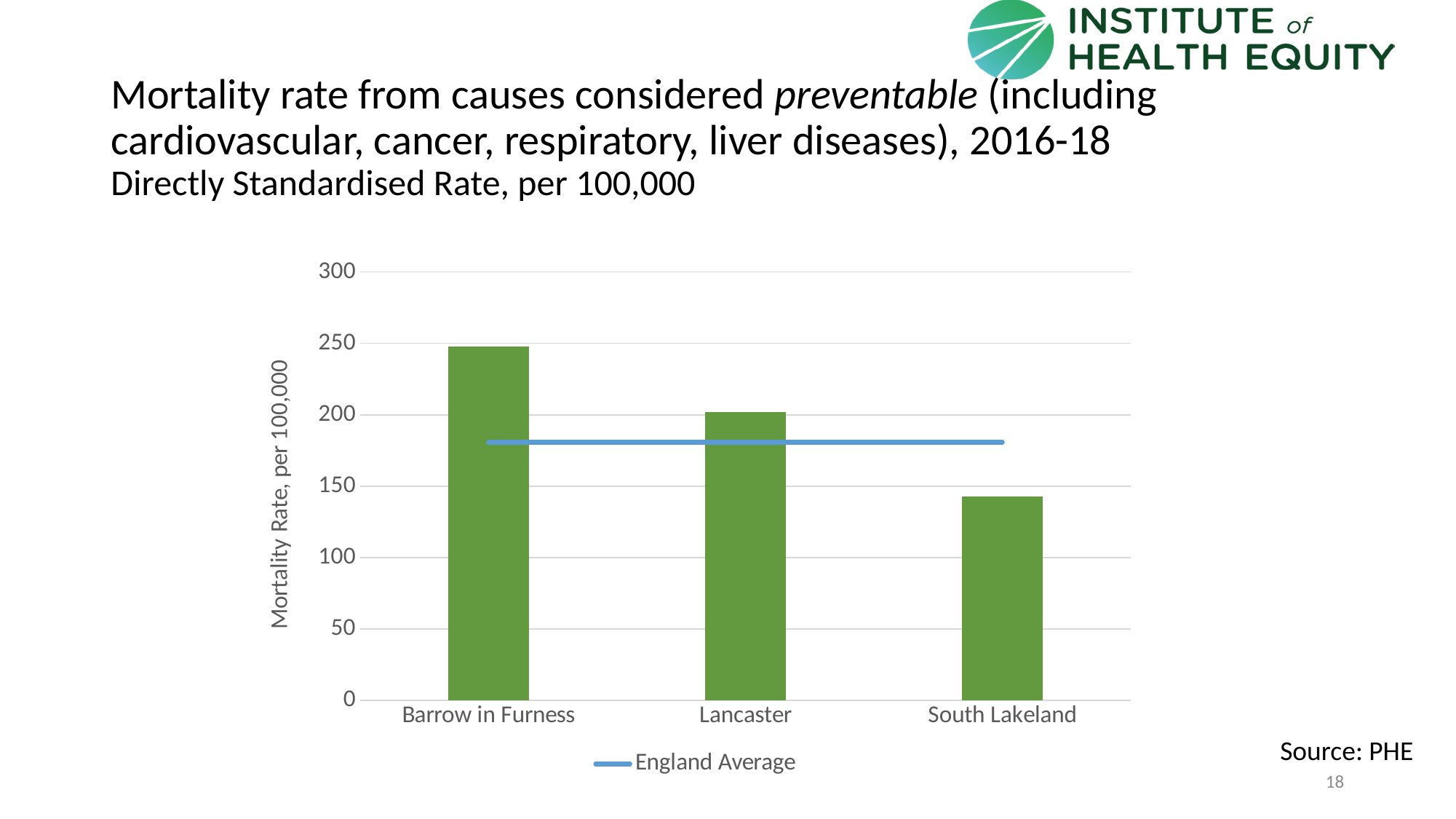
Is the England Average line above or below 200? below Is the value for Lancaster greater or less than 250? less How many entries does the chart legend list? 1 How many areas are shown as bars on the chart? 3 Is the value for Barrow in Furness greater or less than 200? greater Which area has the highest mortality rate from preventable causes? Barrow in Furness Which area has the lowest mortality rate from preventable causes? South Lakeland What does the blue horizontal line on the chart represent? England Average What kind of chart is used to show the mortality rates? Bar chart Do the bar values rise or fall from left to right across the areas? Fall Which has the higher mortality rate, Lancaster or South Lakeland? Lancaster